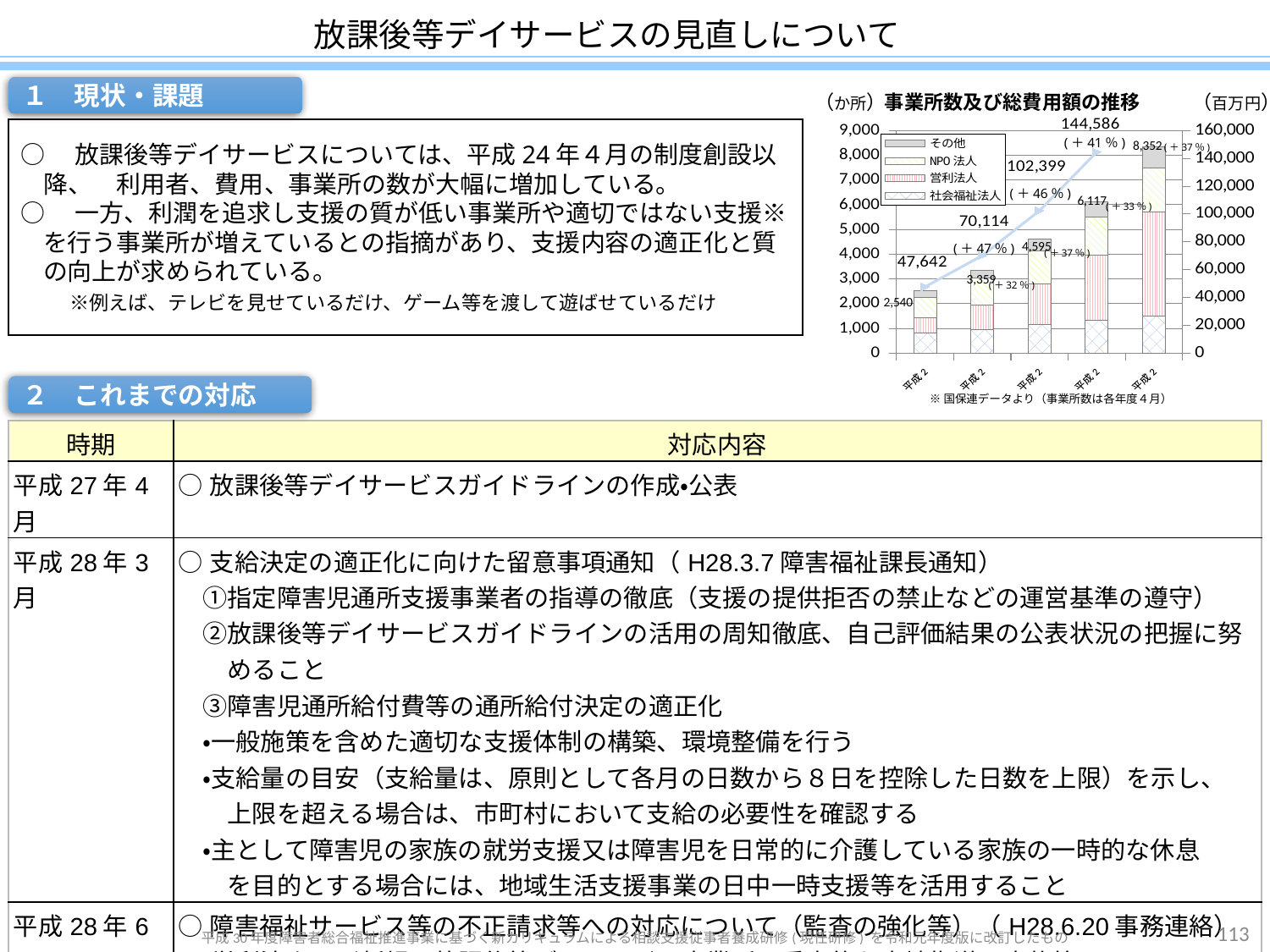
Is the total of the rightmost bar greater or less than 8,000? greater What is the total value labelled on the tallest (rightmost) stacked bar? 8,352 How many entries does the chart's legend list? 4 Do the stacked bar totals rise or fall from left to right along the x axis? rise What is the total value labelled on the first (leftmost) stacked bar? 2,540 What is the title of the chart on the slide? 事業所数及び総費用額の推移 What is the highest value labelled on the line series? 144,586 What kind of chart is shown on the slide? bar chart with a line What is the difference between the two highest labelled line values, 144,586 and 102,399? 42,187 What is the difference between the total of the rightmost bar (8,352) and the total of the leftmost bar (2,540)? 5,812 How many bars are plotted in the chart? 5 What is the lowest value labelled on the line series? 47,642